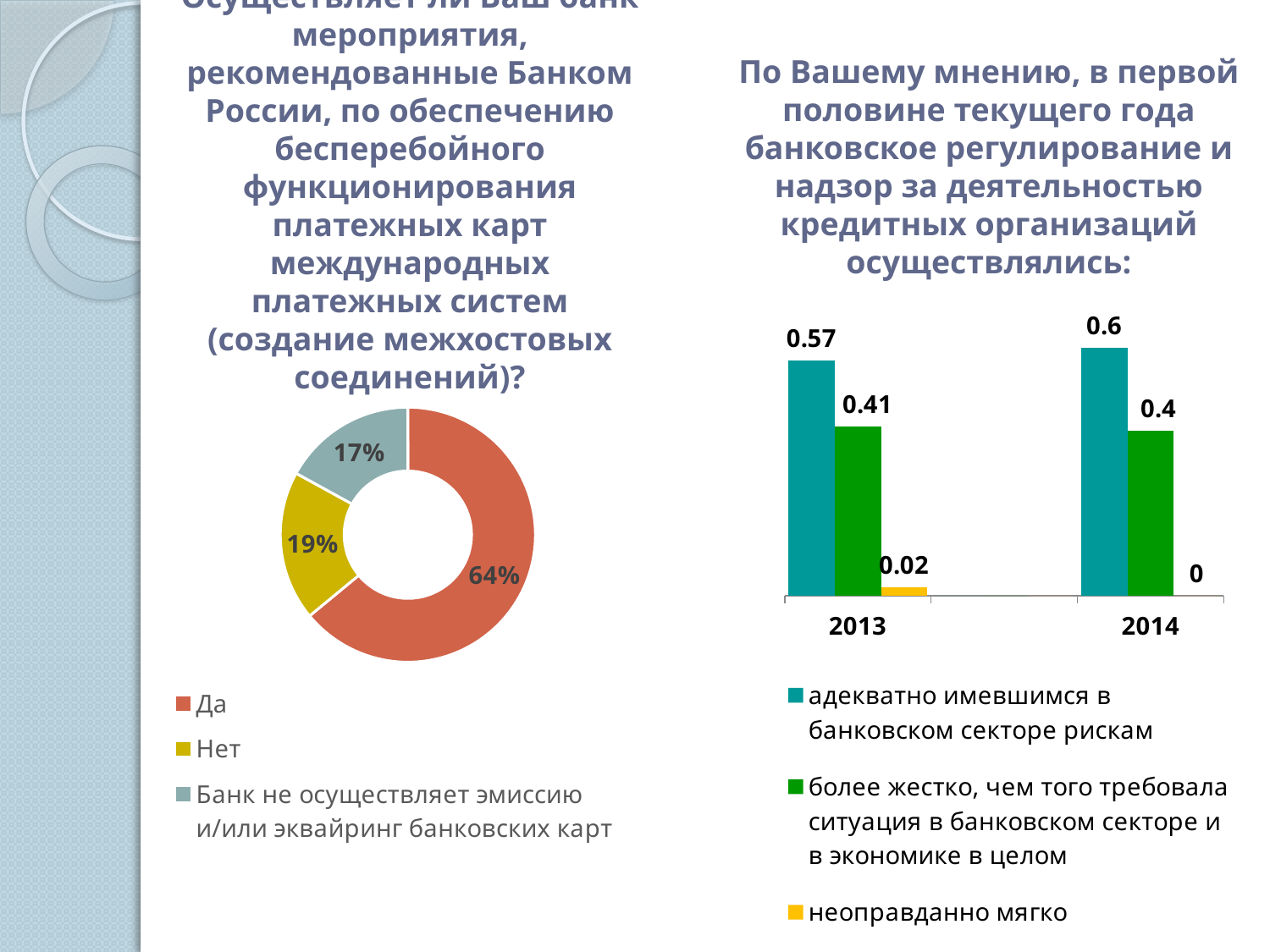
In the left doughnut chart, what share of respondents answered "Да"? 64% In the left doughnut chart, which category has the largest share? Да In the right bar chart, what is the value for "более жестко, чем того требовала ситуация в банковском секторе и в экономике в целом" in 2014? 0.4 In the left doughnut chart, what share corresponds to "Банк не осуществляет эмиссию и/или эквайринг банковских карт"? 17% In the left doughnut chart, what share of respondents answered "Нет"? 19% In the right bar chart, how many series does the legend list? 3 In the right bar chart, which is larger: the 2013 or the 2014 value for "адекватно имевшимся в банковском секторе рискам"? 2014 In the right bar chart, what is the value for "адекватно имевшимся в банковском секторе рискам" in 2013? 0.57 What type of chart is the left chart on the slide? Doughnut (pie) chart In the right bar chart, what is the value for "неоправданно мягко" in 2013? 0.02 In the left doughnut chart, how many percentage points larger is "Да" than "Нет"? 45 In the left doughnut chart, which category has the smallest share? Банк не осуществляет эмиссию и/или эквайринг банковских карт